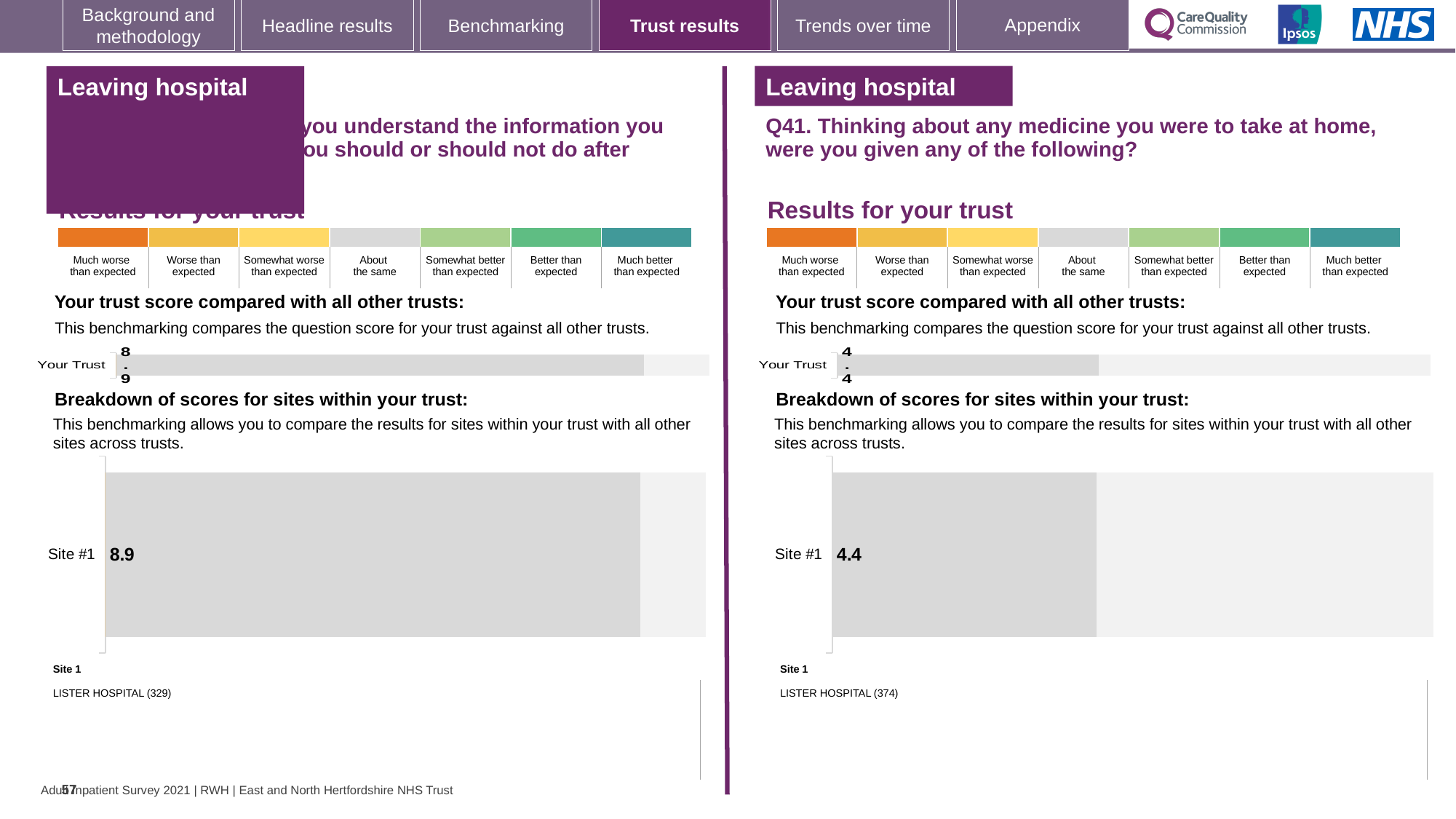
On the right half of the slide (Q41), in the 'Breakdown of scores for sites within your trust' chart, what is the value for Site #1? 4.4 On the right half of the slide (Q41), which hospital is listed as Site 1 below the site breakdown chart? LISTER HOSPITAL (374) How many sites are shown in the 'Breakdown of scores for sites within your trust' chart on the right half of the slide (Q41)? 1 On the right half of the slide (Q41), is the Site #1 value the same as the Your Trust value? Yes, both are 4.4 How many sites are shown in the 'Breakdown of scores for sites within your trust' chart on the left half of the slide? 1 What is the difference between the Your Trust value on the left half of the slide and the Your Trust value on the right half (Q41)? 4.5 On the left half of the slide, in the 'Your trust score compared with all other trusts' chart, what is the value for Your Trust? 8.9 On the left half of the slide, in the 'Breakdown of scores for sites within your trust' chart, what is the value for Site #1? 8.9 Which is larger: the Site #1 value in the left-hand site breakdown chart or the Site #1 value in the right-hand (Q41) site breakdown chart? The left-hand chart (8.9) On the left half of the slide, which hospital is listed as Site 1 below the site breakdown chart? LISTER HOSPITAL (329) What kind of chart is used for the 'Breakdown of scores for sites within your trust' on the left half of the slide? Bar chart On the right half of the slide (Q41), in the 'Your trust score compared with all other trusts' chart, what is the value for Your Trust? 4.4